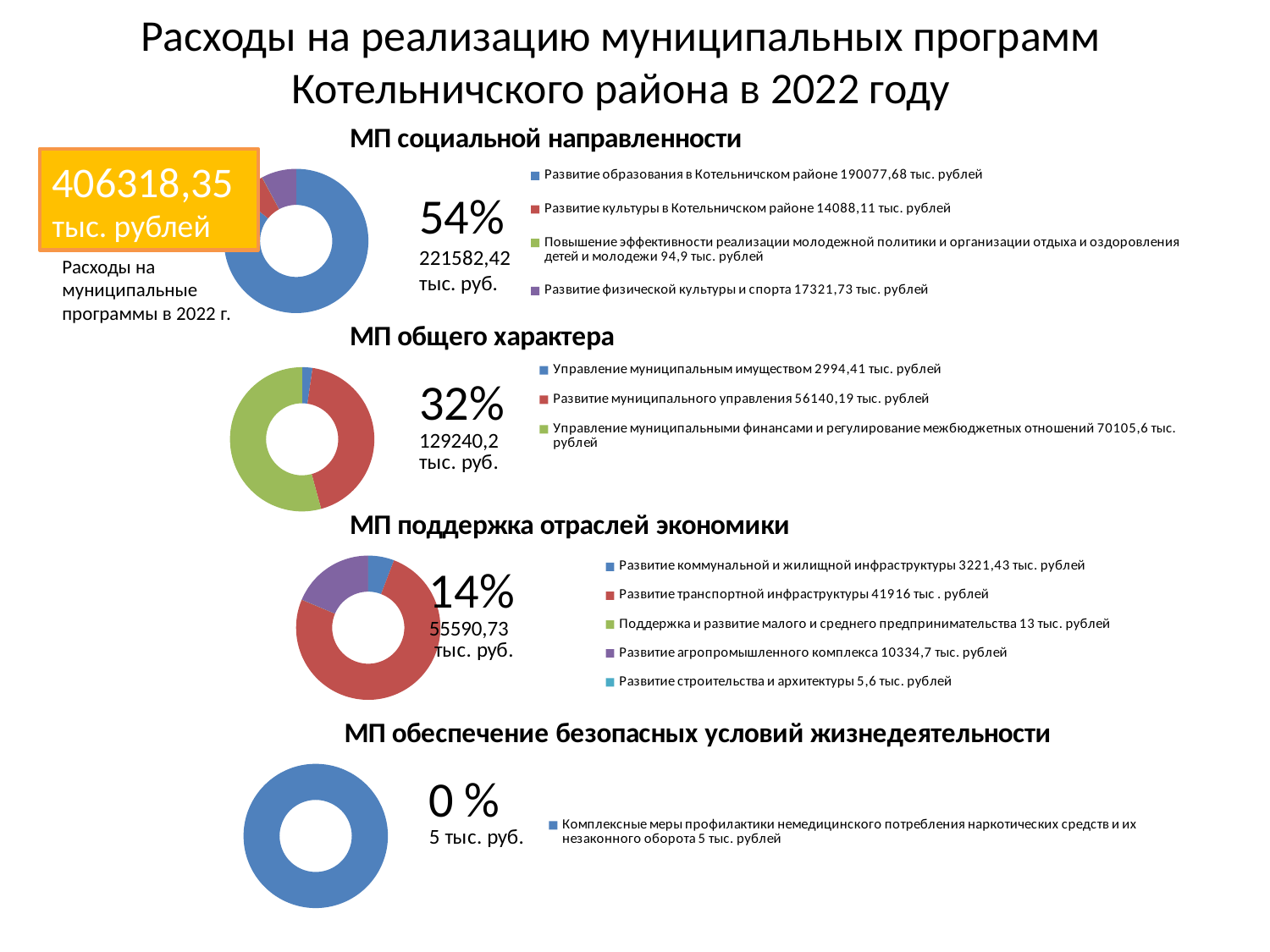
What total amount is shown next to the "МП общего характера" chart? 129240,2 тыс. руб. In the "МП социальной направленности" chart, which category has the smallest value? Повышение эффективности реализации молодежной политики и организации отдыха и оздоровления детей и молодежи How many categories does the legend of the "МП общего характера" chart list? 3 In the "МП обеспечение безопасных условий жизнедеятельности" chart, what is the value of the single category? 5 тыс. рублей In the "МП общего характера" chart, which category has the largest value? Управление муниципальными финансами и регулирование межбюджетных отношений In the "МП поддержка отраслей экономики" chart, what is the difference between "Развитие агропромышленного комплекса" (10334,7) and "Развитие коммунальной и жилищной инфраструктуры" (3221,43)? 7113,27 тыс. рублей How many categories does the legend of the "МП поддержка отраслей экономики" chart list? 5 What kind of chart is used for "МП социальной направленности"? Doughnut (pie) chart In the "МП общего характера" chart, what is the value for "Развитие муниципального управления"? 56140,19 тыс. рублей In the "МП поддержка отраслей экономики" chart, which is larger: "Развитие транспортной инфраструктуры" or "Развитие агропромышленного комплекса"? Развитие транспортной инфраструктуры What percentage share is shown for the "МП поддержка отраслей экономики" chart? 14% In the "МП социальной направленности" chart, what is the value for "Развитие образования в Котельничском районе"? 190077,68 тыс. рублей